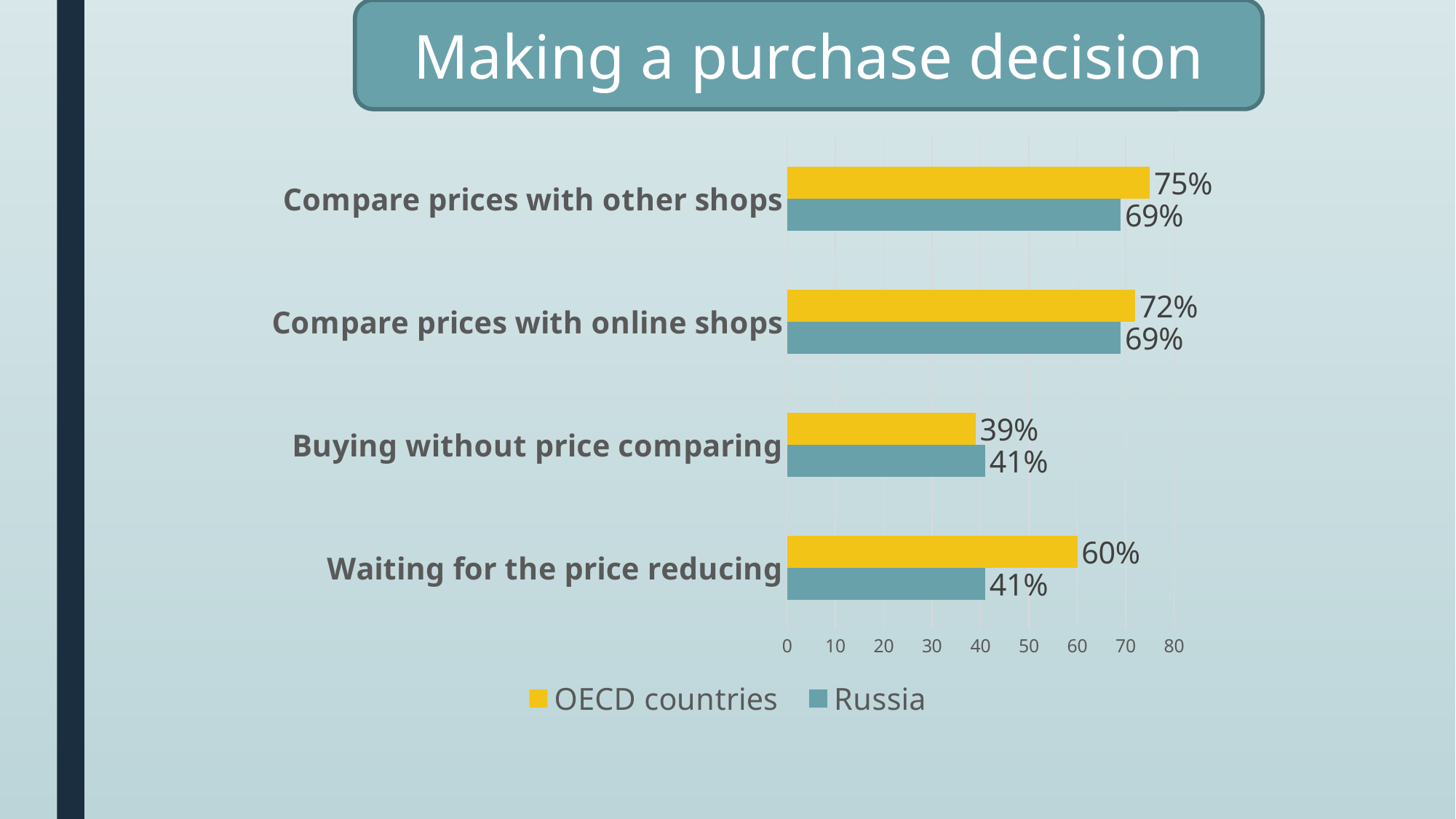
What is the value for Russia for 'Waiting for the price reducing'? 41% For 'Buying without price comparing', which is larger: OECD countries or Russia? Russia How many series does the legend list? 2 What is the difference between OECD countries and Russia for 'Compare prices with other shops'? 6% What is the value for Russia for 'Compare prices with online shops'? 69% What kind of chart is shown on the slide? Bar chart How many categories are shown on the chart? 4 Which category has the highest value for OECD countries? Compare prices with other shops What is the value for OECD countries for 'Compare prices with other shops'? 75% What is the value for OECD countries for 'Buying without price comparing'? 39% What is the difference between OECD countries and Russia for 'Waiting for the price reducing'? 19% Which category has the lowest value for OECD countries? Buying without price comparing